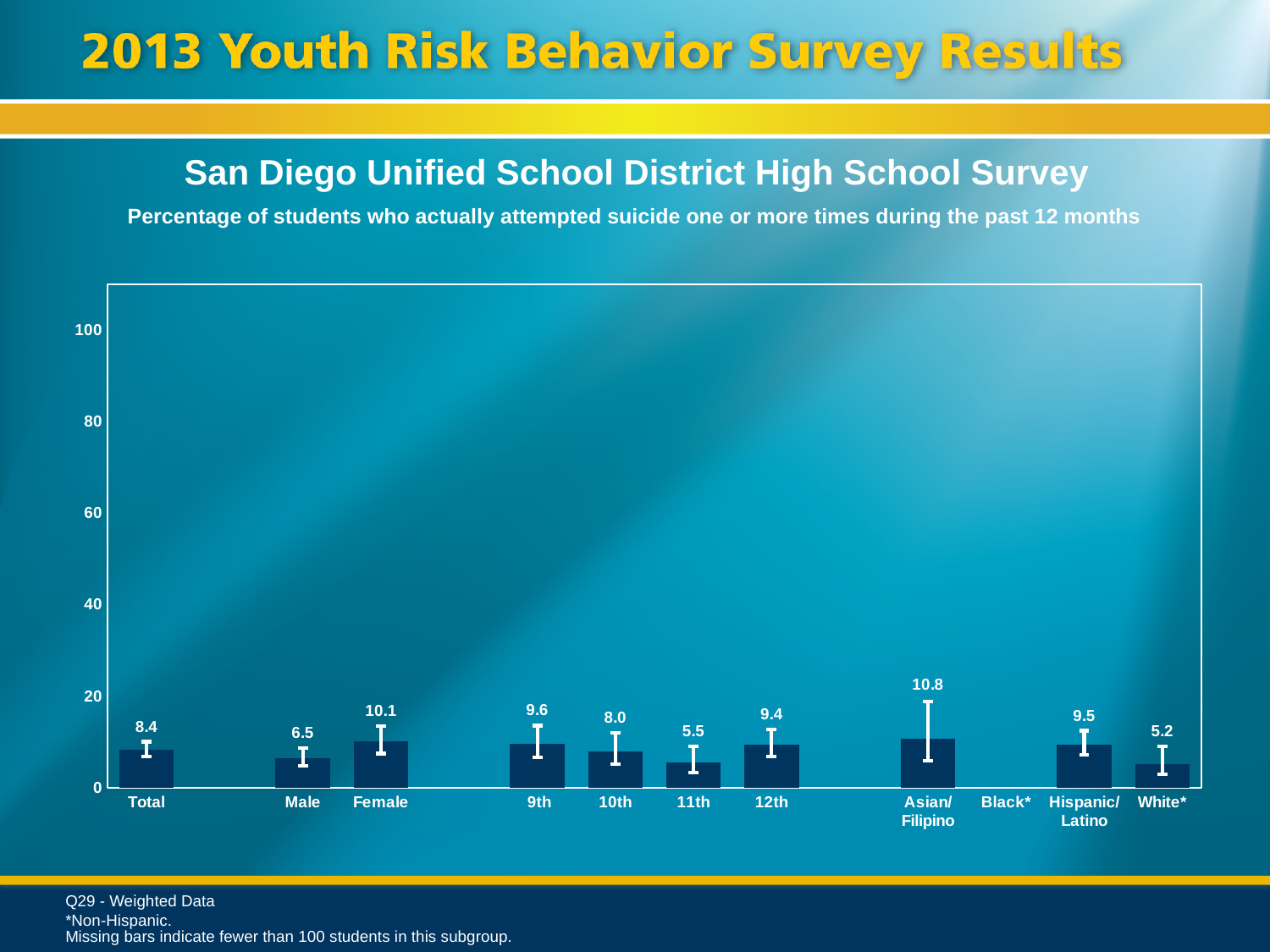
What is the value for Total? 8.4 What is the value for 11th grade? 5.5 Which category has the highest value? Asian/Filipino What is the difference between the Female and Male values? 3.6 What is the value for Asian/Filipino? 10.8 What kind of chart is this? bar chart Which category label has no bar plotted? Black* What is the value for Female? 10.1 How many categories have a plotted bar? 11 Which is larger, the value for 9th grade or the value for 12th grade? 9th Is the value for Hispanic/Latino greater or less than 20? less Which category with a plotted bar has the lowest value? White*